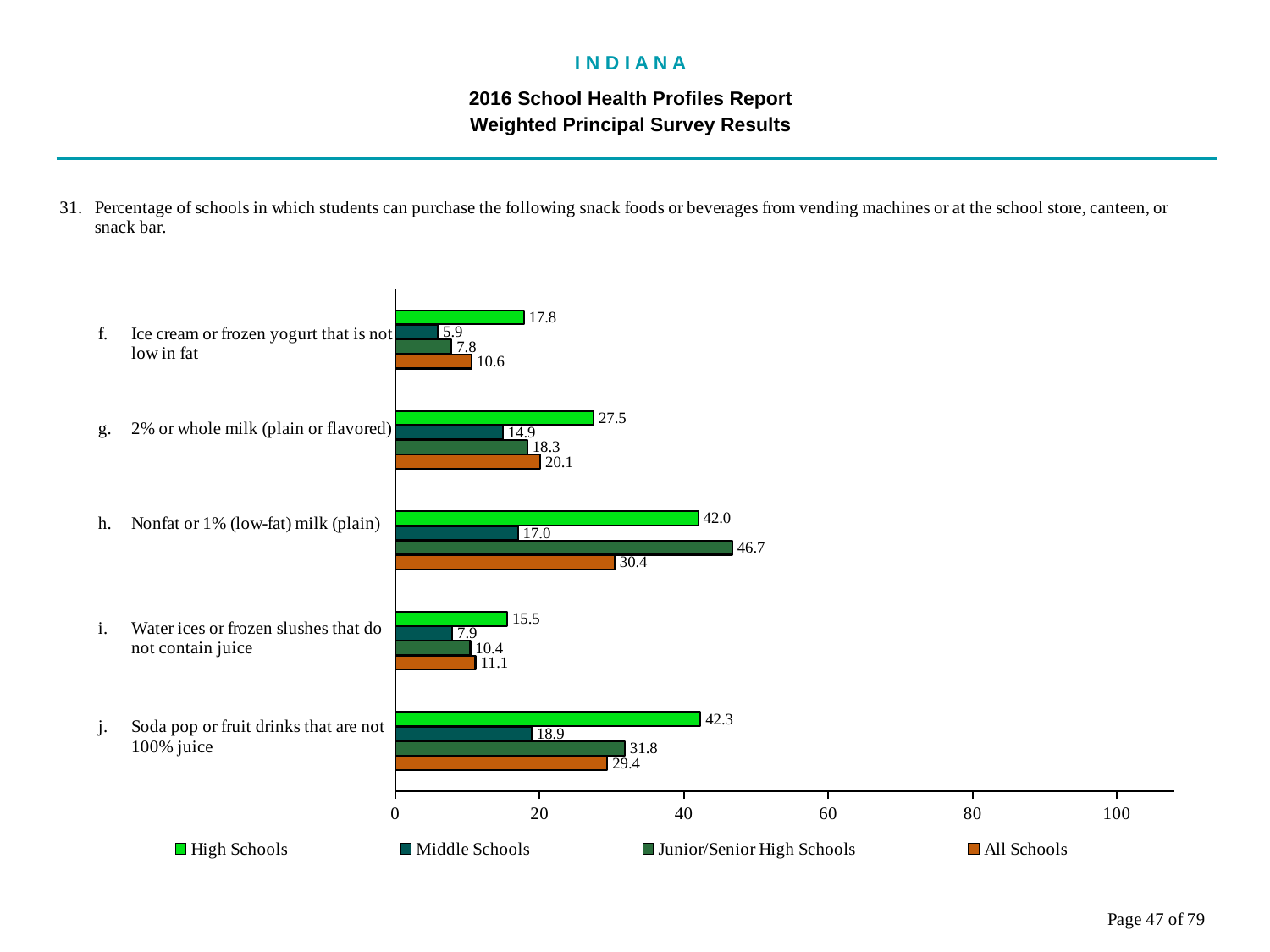
What kind of chart is shown on the slide? Bar chart Which category has the lowest value for Middle Schools? Ice cream or frozen yogurt that is not low in fat How many snack food or beverage categories are shown on the chart? 5 Is the All Schools value for 'Nonfat or 1% (low-fat) milk (plain)' greater or less than 20? greater What is the value for High Schools for 'Nonfat or 1% (low-fat) milk (plain)'? 42.0 Which category has the highest value for Junior/Senior High Schools? Nonfat or 1% (low-fat) milk (plain) For 'Nonfat or 1% (low-fat) milk (plain)', which is larger: the High Schools value or the Junior/Senior High Schools value? Junior/Senior High Schools How many series does the legend list? 4 What is the value for Middle Schools for 'Ice cream or frozen yogurt that is not low in fat'? 5.9 What is the value for All Schools for 'Soda pop or fruit drinks that are not 100% juice'? 29.4 What is the difference between the High Schools and Middle Schools values for 'Soda pop or fruit drinks that are not 100% juice'? 23.4 What is the value for Junior/Senior High Schools for '2% or whole milk (plain or flavored)'? 18.3